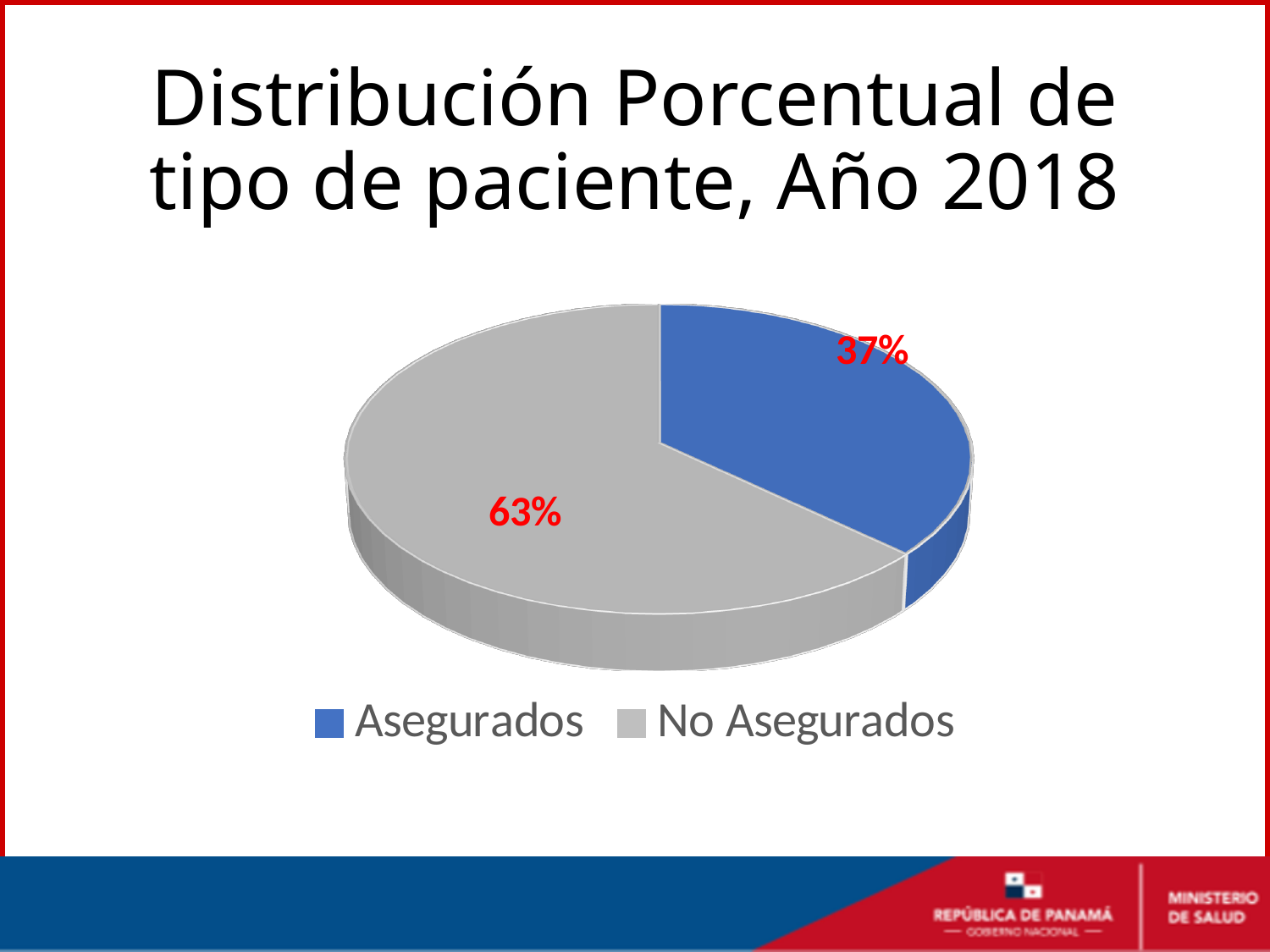
What is the title of the chart on the slide? Distribución Porcentual de tipo de paciente, Año 2018 Which is larger, the share of Asegurados or the share of No Asegurados? No Asegurados Which category has the smallest share of the pie? Asegurados What share of the pie does the Asegurados slice represent? 37% What percentage of patients are No Asegurados? 63% What kind of chart is shown on the slide? Pie chart What percentage of patients are Asegurados? 37% Which category has the largest share of the pie? No Asegurados How many categories does the pie chart show? 2 What is the difference in percentage points between No Asegurados and Asegurados? 26 What colour is the Asegurados slice? Blue How many entries does the legend list? 2